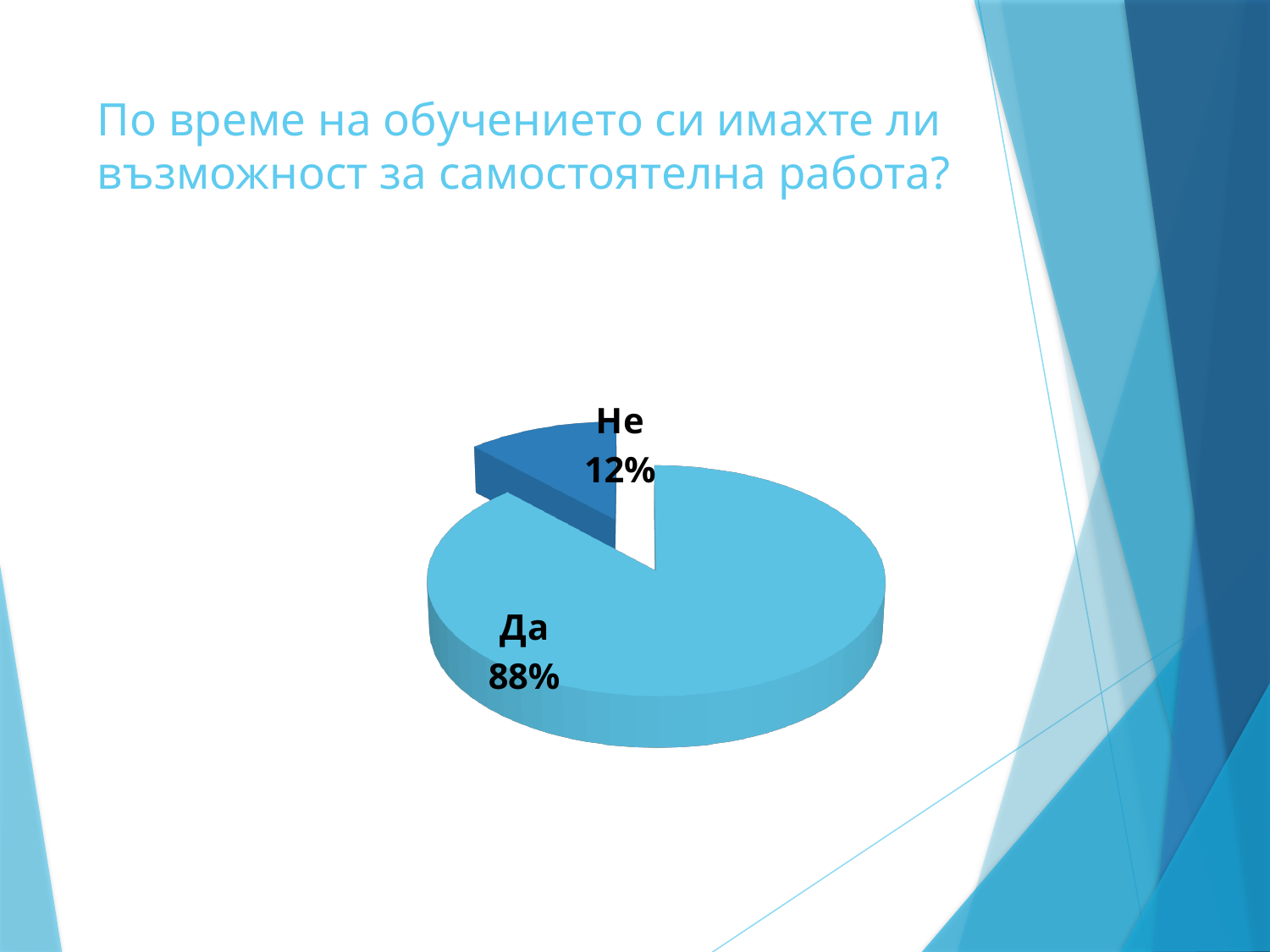
Which answer has the largest share of the pie? Да What share of the pie does the "Не" slice represent? 12% What is the difference in percentage points between the "Да" and "Не" slices? 76 What kind of chart is shown on the slide? Pie chart Which slice is pulled out (exploded) from the pie? Не How many slices does the pie chart have? 2 What is the title of the slide containing the chart? По време на обучението си имахте ли възможност за самостоятелна работа? What percentage of respondents answered "Да"? 88% Which slice is larger, "Да" or "Не"? Да Which answer has the smallest share of the pie? Не What percentage of respondents answered "Не"? 12%